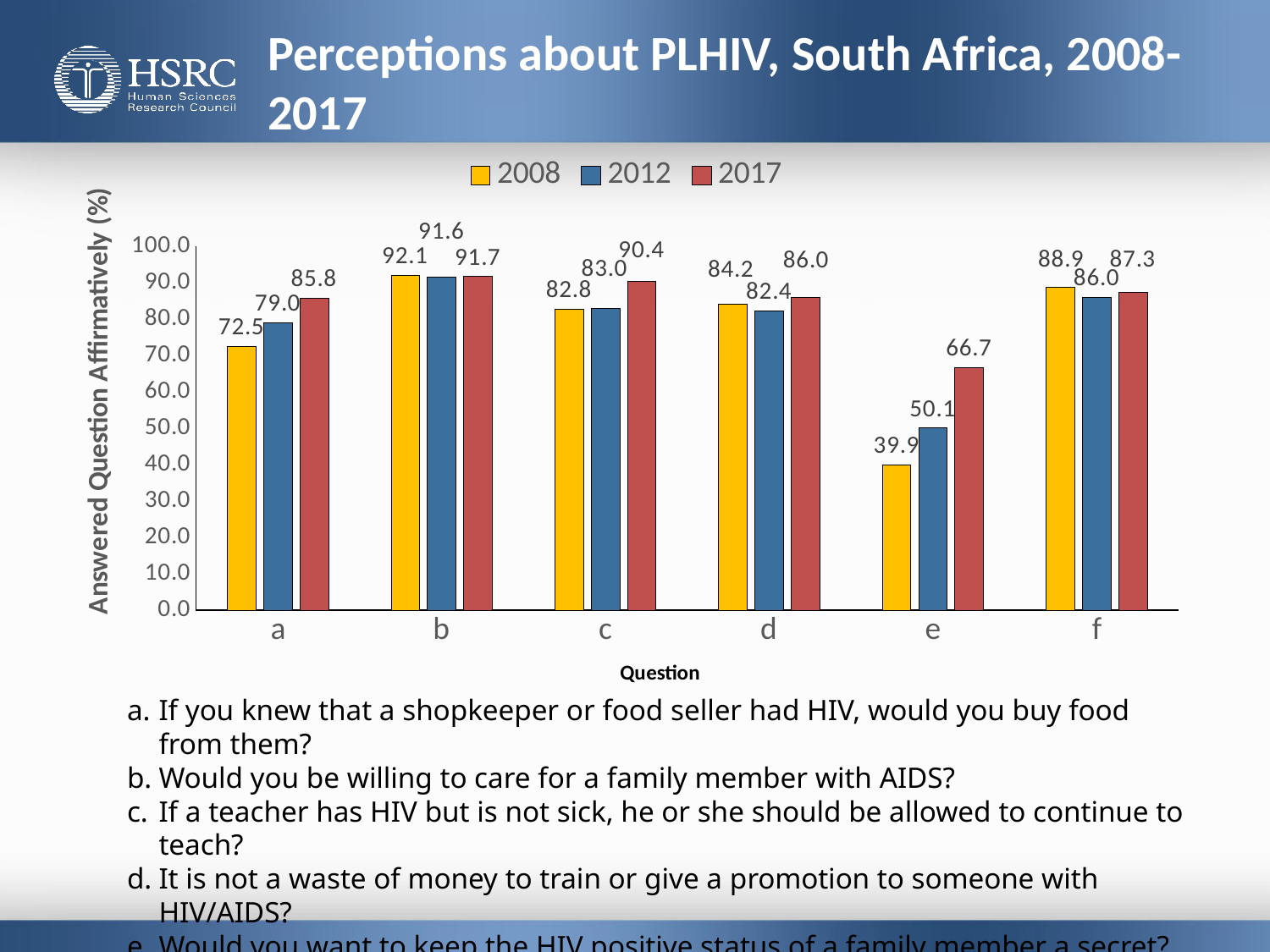
What is the difference between the 2017 and 2008 values for question e? 26.8 Which question has the lowest 2008 value? e Which question has the highest 2017 value? b Is the 2012 value for question e greater or less than 60.0? less What is the 2017 value for question e? 66.7 What kind of chart is shown on the slide? bar chart What is the 2012 value for question c? 83.0 For question d, which year has the larger value, 2008 or 2012? 2008 How many questions (categories) are shown on the x axis? 6 What is the 2008 value for question a? 72.5 How many series does the legend list? 3 Do the values for question e rise or fall from 2008 to 2017? rise